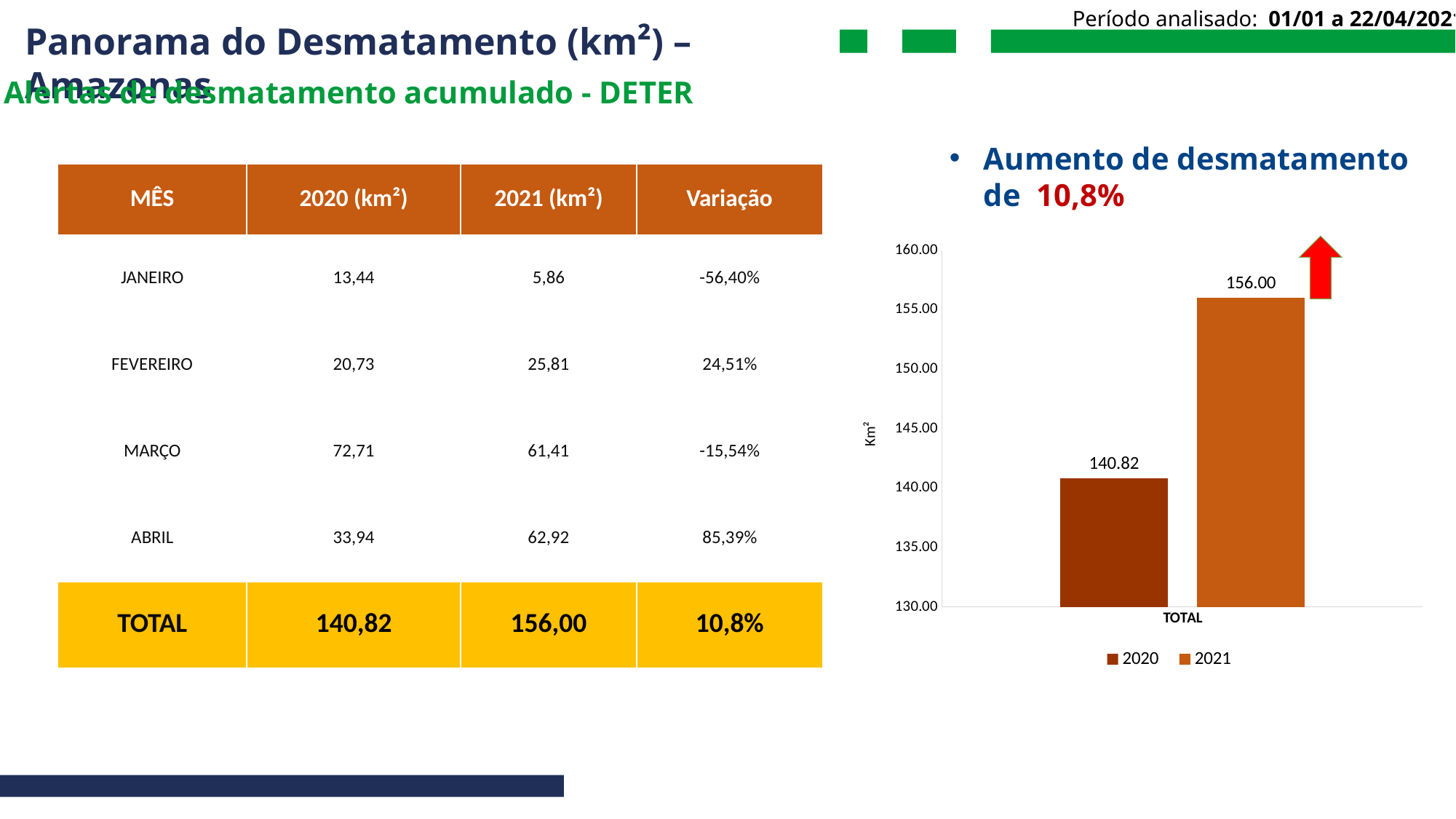
What type of chart is shown on the slide? bar chart How many categories are shown on the x axis of the chart? 1 What is the label of the y axis of the chart? Km² Is the value of the 2020 bar greater or less than 145.00? less What is the label of the category on the x axis of the chart? TOTAL What is the value of the 2020 bar in the chart? 140.82 What is the value of the 2021 bar in the chart? 156.00 Is the value of the 2021 bar greater or less than 150.00? greater Which series has the lowest value in the chart? 2020 Which series has the higher bar in the chart, 2020 or 2021? 2021 How many series does the chart legend list? 2 What is the difference between the 2021 and 2020 bars in the chart? 15.18